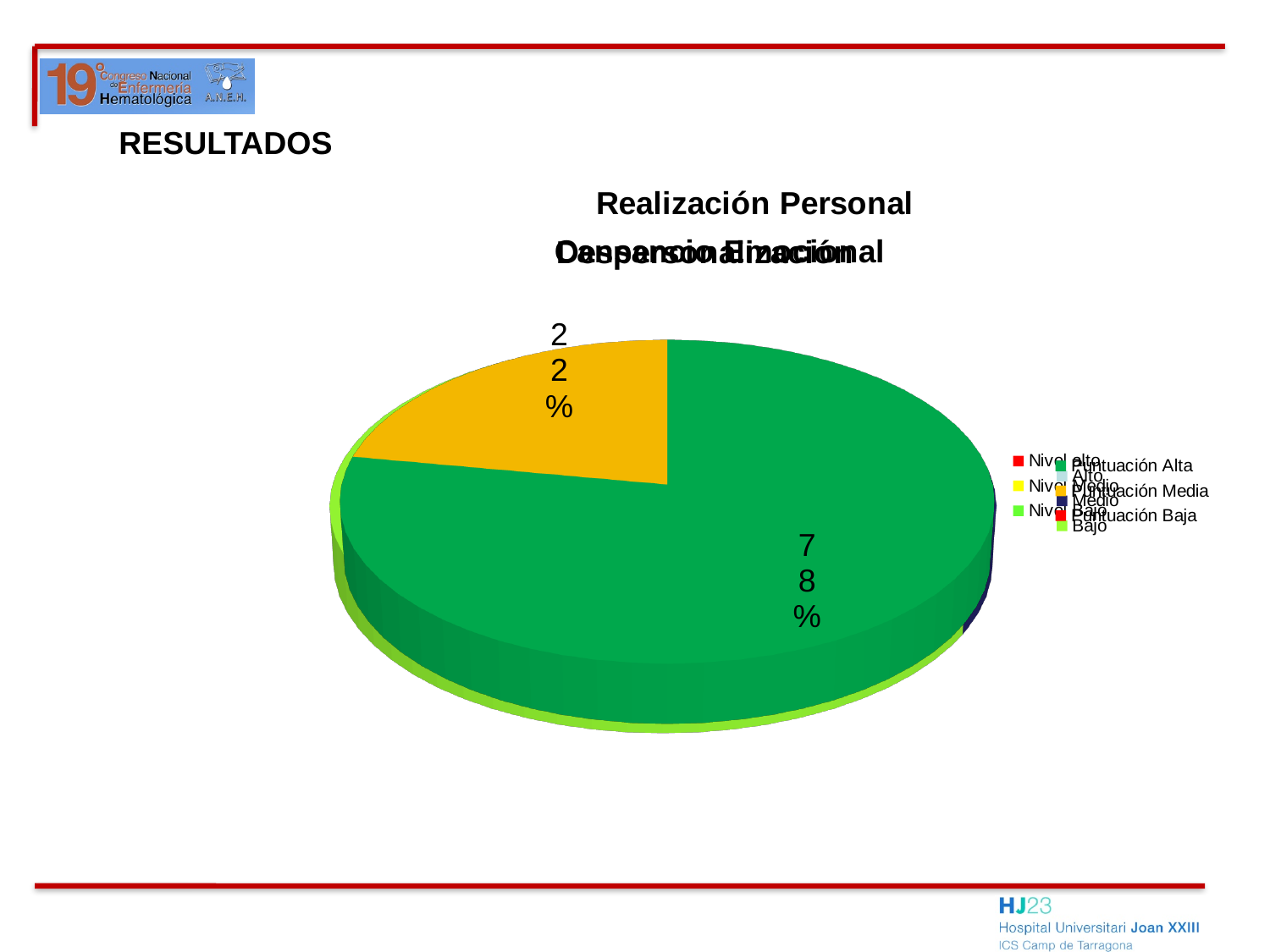
Which slice is larger, the green slice or the yellow slice? the green slice What percentage is labelled on the yellow slice of the pie chart? 22% What kind of chart is shown on the slide? pie chart What colour is the largest slice of the pie chart? green Is the green slice's share greater or less than 50%? greater How many slices are visible in the pie chart? 2 What is the difference between the green slice's percentage and the yellow slice's percentage? 56% What is the title printed at the top of the chart? Realización Personal What is the smallest percentage shown on the pie chart? 22% What do the two labelled slices of the pie chart add up to? 100% What is the largest percentage shown on the pie chart? 78% What percentage is labelled on the green slice of the pie chart? 78%